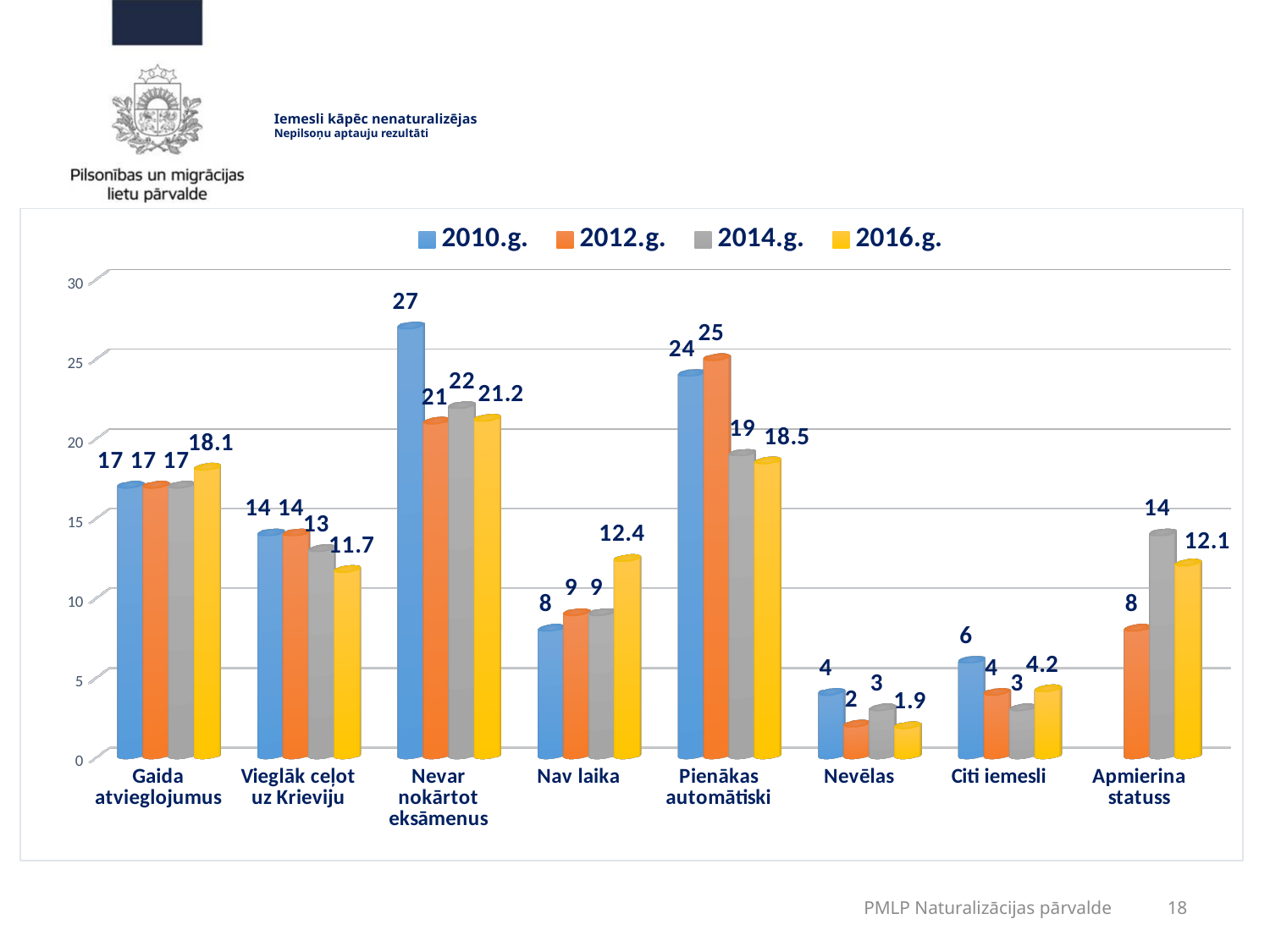
What is the difference between the 2010.g. and 2016.g. values in the category "Nevar nokārtot eksāmenus"? 5.8 What is the value for 2014.g. in the category "Apmierina statuss"? 14 How many series does the legend list? 4 What is the value for 2010.g. in the category "Nevar nokārtot eksāmenus"? 27 Which is larger in the category "Pienākas automātiski": the value for 2010.g. or for 2012.g.? 2012.g. Do the values for 2016.g. rise or fall from "Gaida atvieglojumus" to "Vieglāk ceļot uz Krieviju"? fall What is the value for 2016.g. in the category "Nav laika"? 12.4 Which category has the lowest value for 2016.g.? Nevēlas What type of chart is shown on the slide? bar chart Which category has the highest value for 2012.g.? Pienākas automātiski How many categories are shown on the x axis? 8 Which series is shown in yellow in the legend? 2016.g.